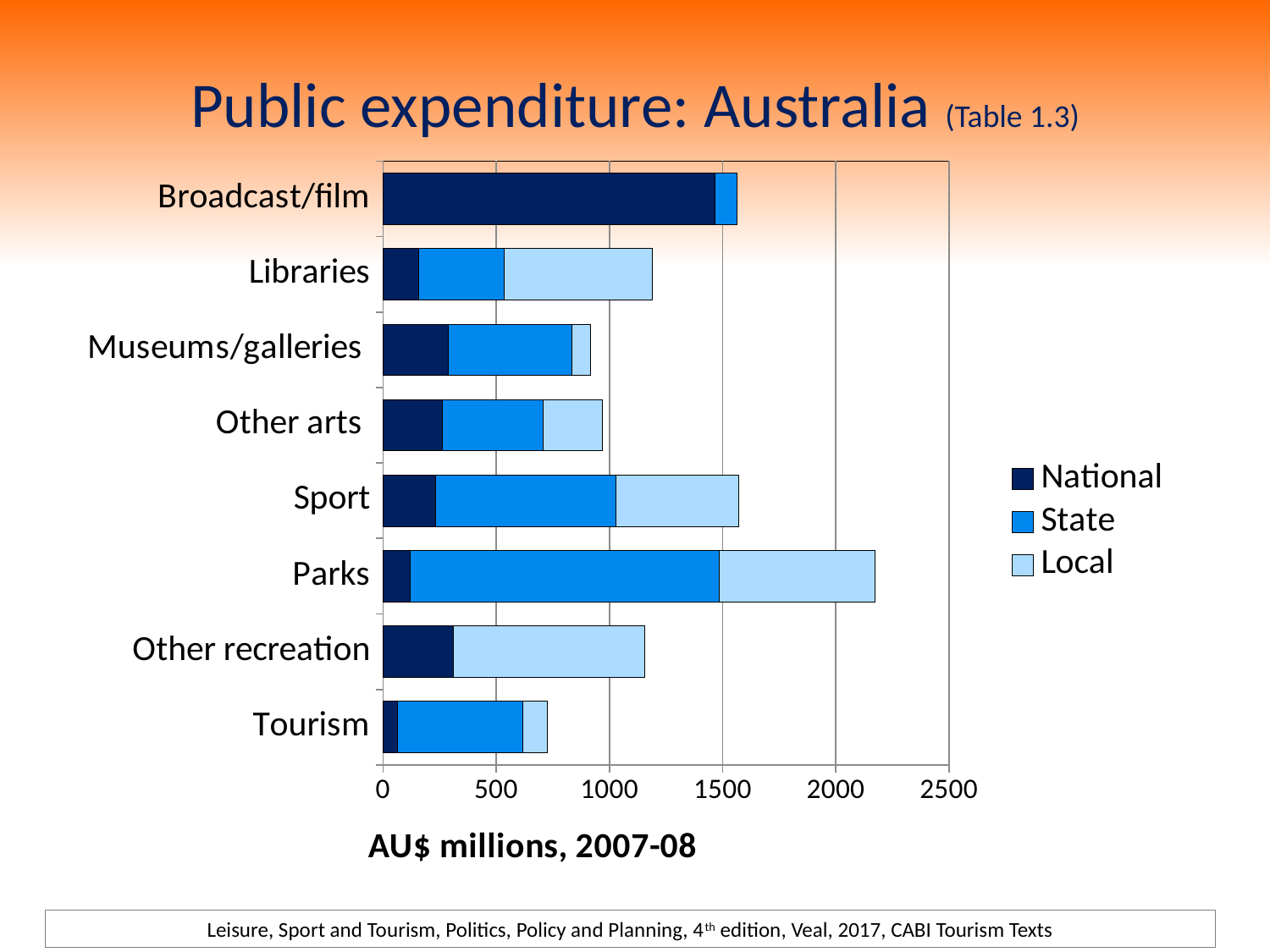
Which has the larger total expenditure, Parks or Sport? Parks Which has the larger total expenditure, Other arts or Tourism? Other arts What is the label on the horizontal axis of the chart? AU$ millions, 2007-08 What kind of chart is shown on the slide? Stacked bar chart Which category has the lowest total public expenditure? Tourism Is the total value for Libraries greater or less than 1000? greater How many expenditure categories are plotted on the chart? 8 Is the total value for Tourism greater or less than 1000? less Is the total value for Museums/galleries greater or less than 1000? less How many series does the legend list? 3 Which category has the highest total public expenditure? Parks